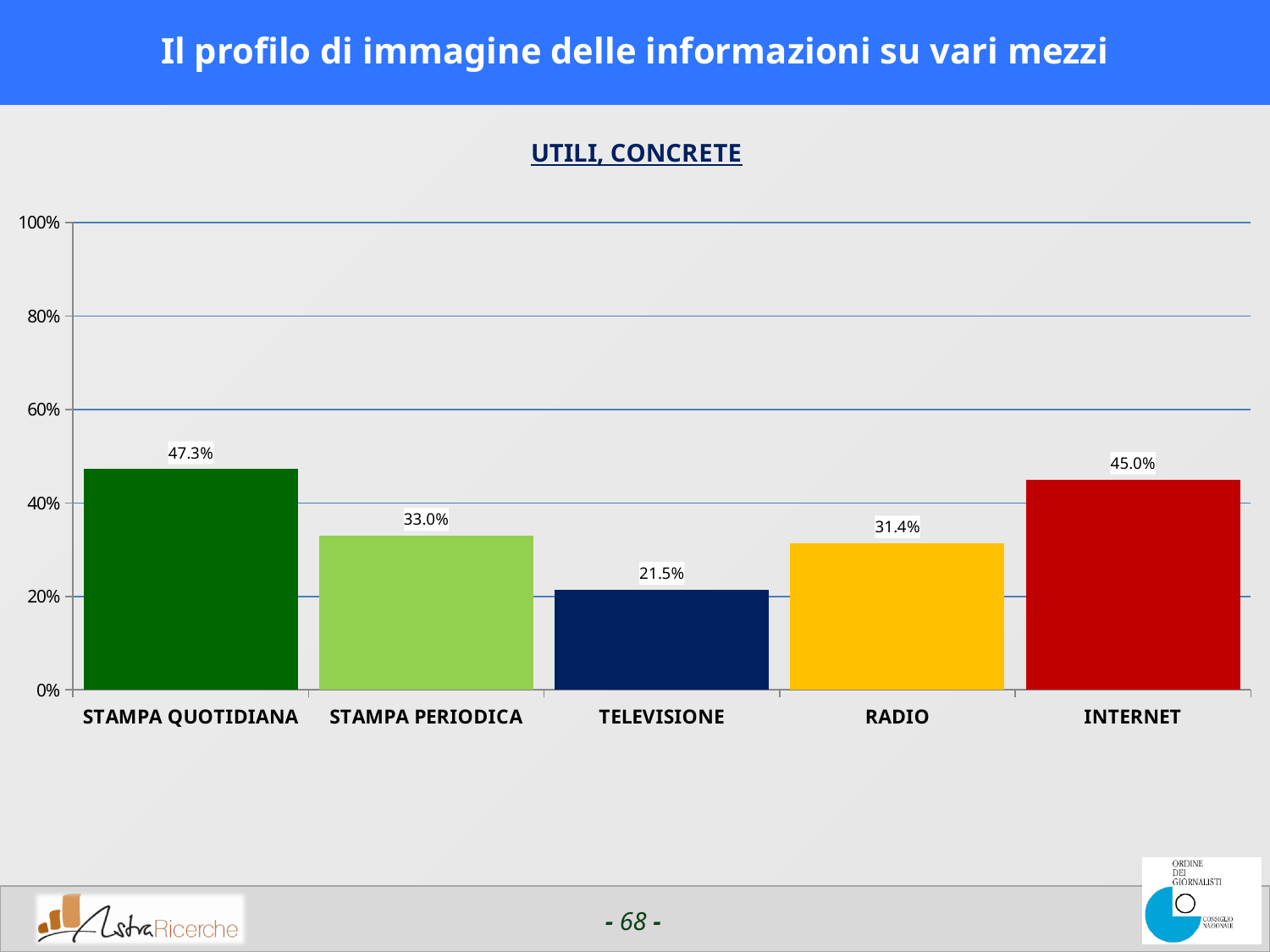
Which category has the highest value? STAMPA QUOTIDIANA Which is larger, the value for STAMPA PERIODICA or the value for RADIO? STAMPA PERIODICA What is the difference between the values for STAMPA PERIODICA and TELEVISIONE? 11.5% Which category has the lowest value? TELEVISIONE What is the difference between the values for STAMPA QUOTIDIANA and INTERNET? 2.3% What kind of chart is shown on the slide? Bar chart What is the title shown above the chart? UTILI, CONCRETE What is the value for TELEVISIONE? 21.5% What is the value for RADIO? 31.4% How many categories are shown on the x axis? 5 What is the value for INTERNET? 45.0% What is the value for STAMPA QUOTIDIANA? 47.3%